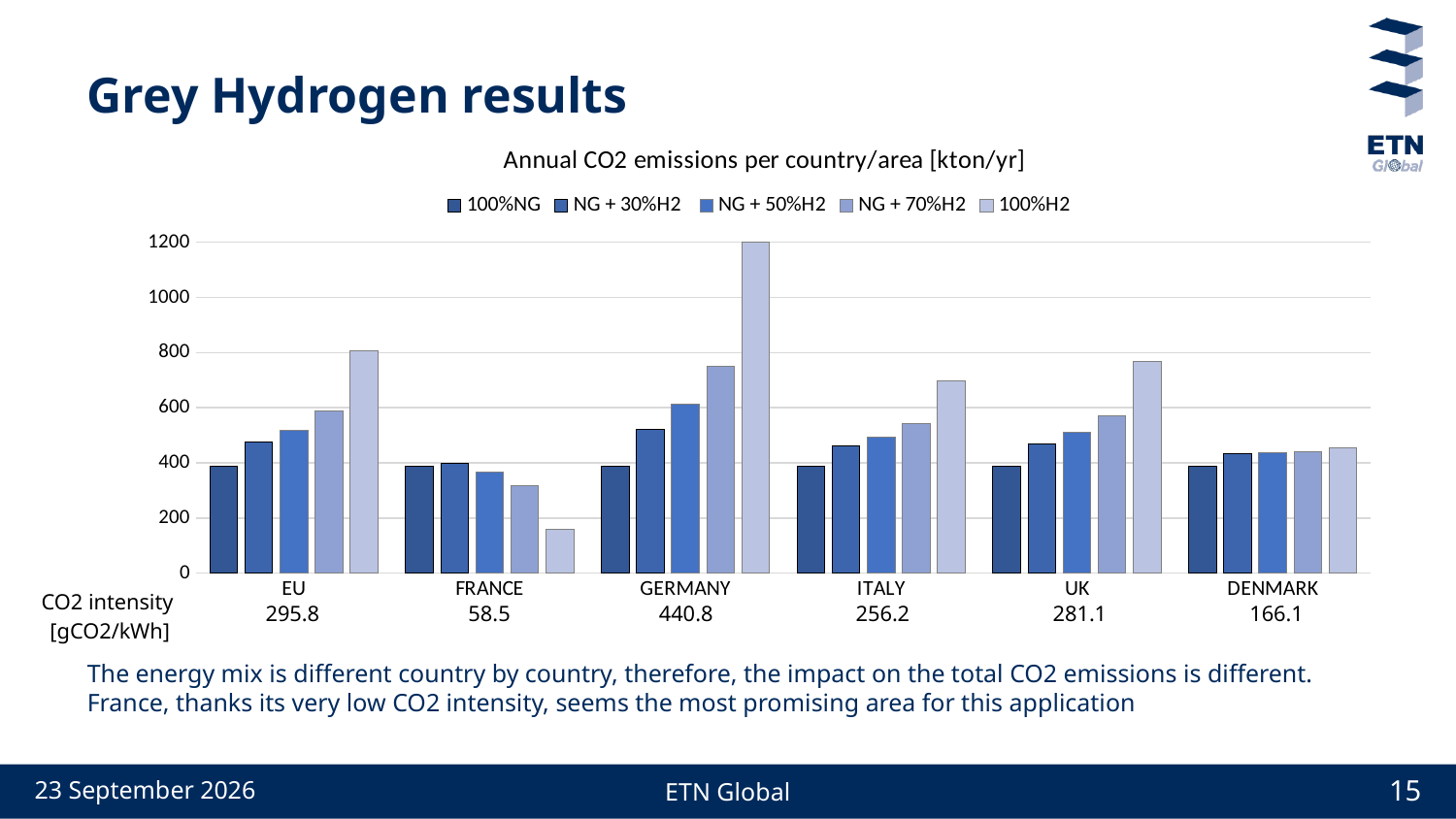
How many series does the legend list? 5 Is the 100%H2 value for FRANCE greater or less than 200? less How many countries/areas are shown on the x axis? 6 Is the 100%H2 value for EU greater or less than 600? greater What type of chart is shown on the slide? bar chart For GERMANY, do the bars rise or fall as the hydrogen share increases from 100%NG to 100%H2? rise Which is larger, the 100%H2 value for UK or the 100%H2 value for ITALY? UK For FRANCE, do the bars rise or fall as the hydrogen share increases from 100%NG to 100%H2? fall Which country/area has the highest 100%H2 bar? GERMANY What is the title of the chart? Annual CO2 emissions per country/area [kton/yr] Is the 100%H2 value for GERMANY greater or less than 1000? greater Which country/area has the lowest 100%H2 bar? FRANCE